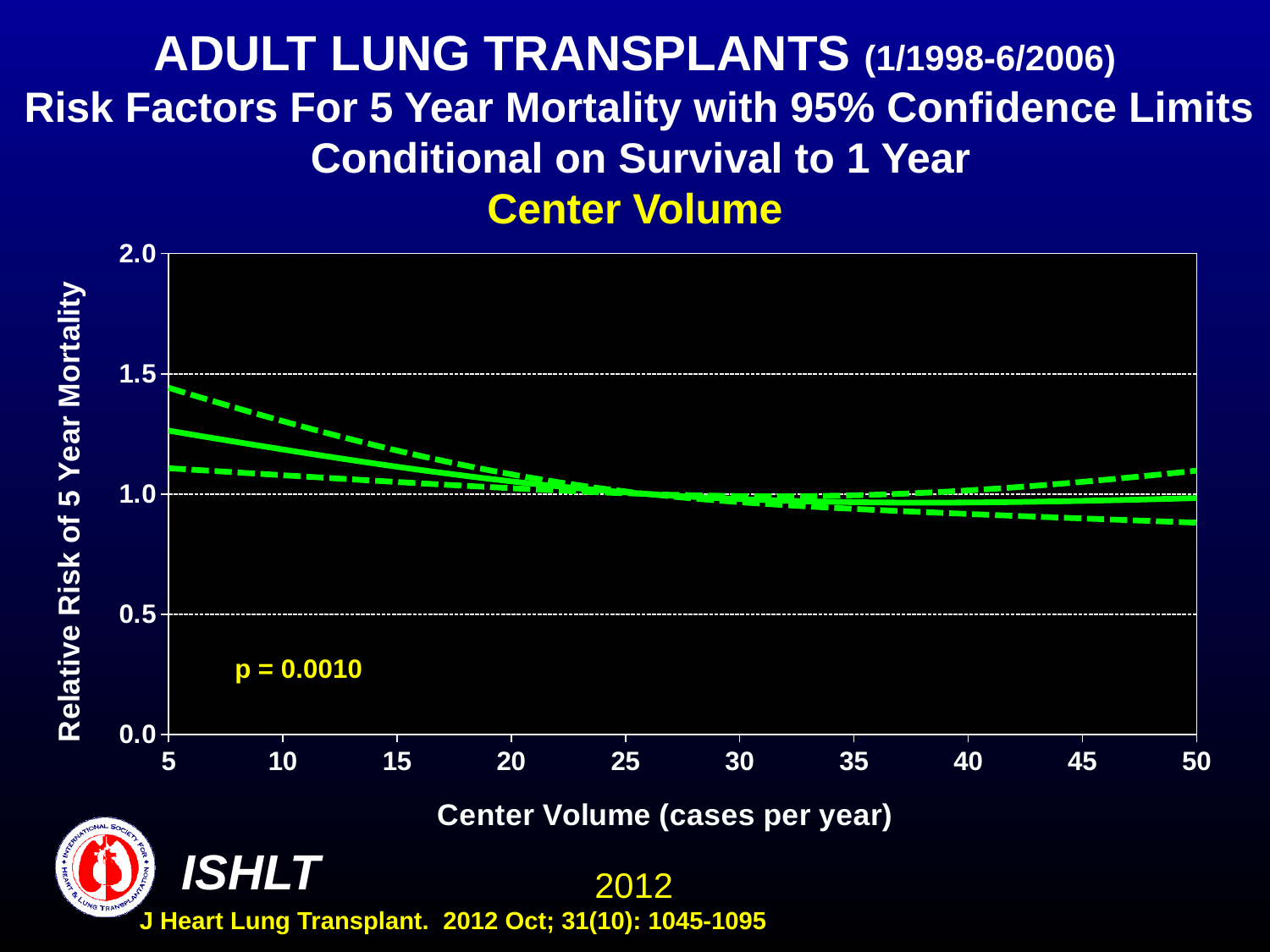
What kind of chart is shown on the slide? line chart What is the smallest center volume shown on the x axis? 5 What is the largest center volume shown on the x axis? 50 Does the solid relative-risk line rise or fall as center volume increases from 5 to 25 cases per year? fall Is the solid relative-risk line at a center volume of 10 cases per year greater or less than 1.5? less How many lines are plotted on the chart? 3 Is the lower dashed confidence limit at a center volume of 50 cases per year greater or less than 1.0? less What is the subtitle naming the risk factor plotted on the chart? Center Volume What is the label of the x axis? Center Volume (cases per year) Is the solid relative-risk line at a center volume of 5 cases per year greater or less than 1.0? greater What is the maximum value shown on the y axis? 2.0